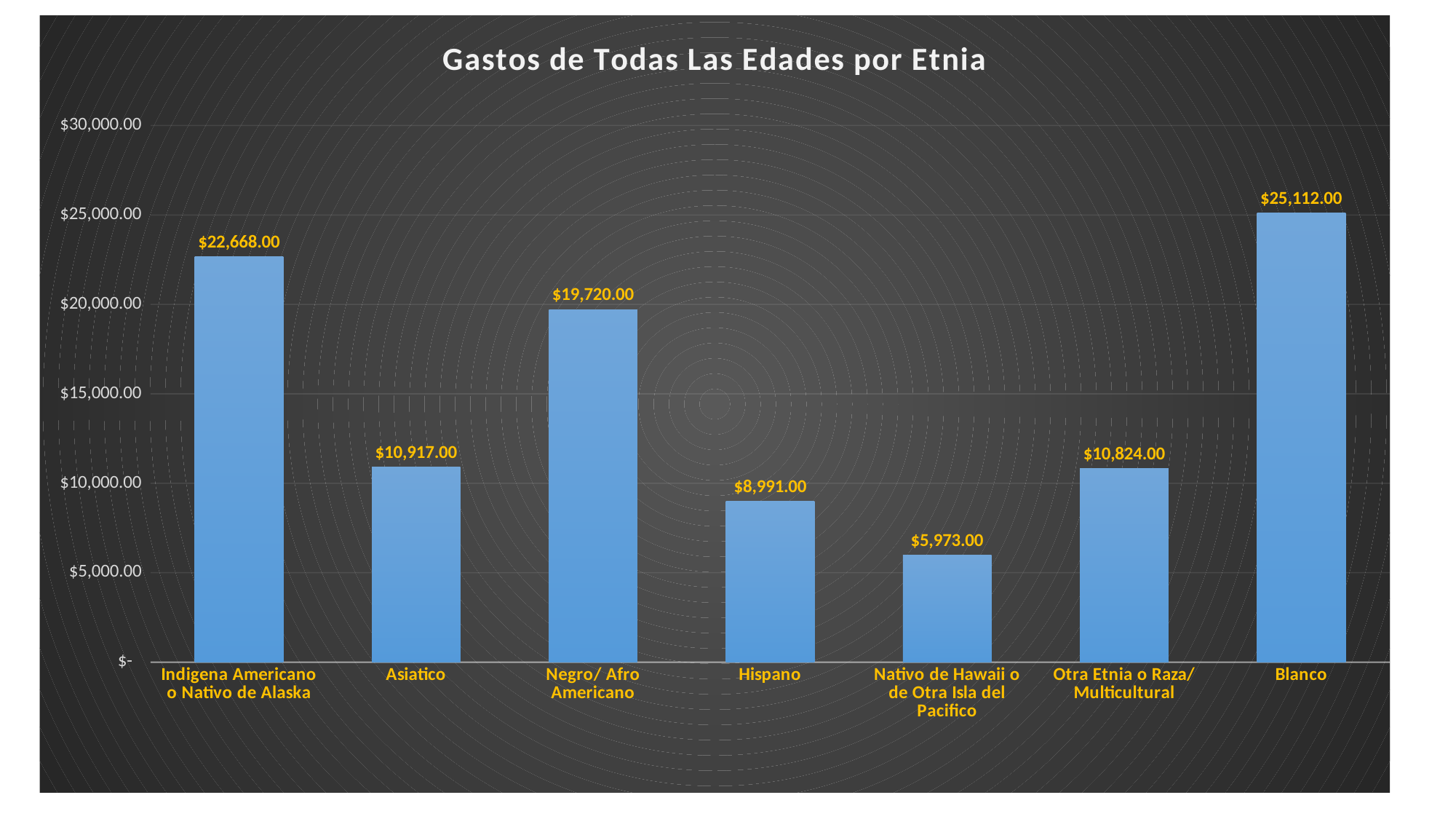
Is the value for Negro/ Afro Americano greater or less than $20,000.00? less What is the value for Hispano? $8,991.00 What is the value for Blanco? $25,112.00 What kind of chart is shown on the slide? bar chart What is the value for Nativo de Hawaii o de Otra Isla del Pacifico? $5,973.00 What is the difference between the values for Blanco and Indigena Americano o Nativo de Alaska? $2,444.00 What is the title of the chart? Gastos de Todas Las Edades por Etnia Which category has the highest value? Blanco How many categories are shown on the x axis? 7 What is the difference between the values for Asiatico and Otra Etnia o Raza/ Multicultural? $93.00 Which is larger, the value for Negro/ Afro Americano or the value for Hispano? Negro/ Afro Americano Which category has the lowest value? Nativo de Hawaii o de Otra Isla del Pacifico